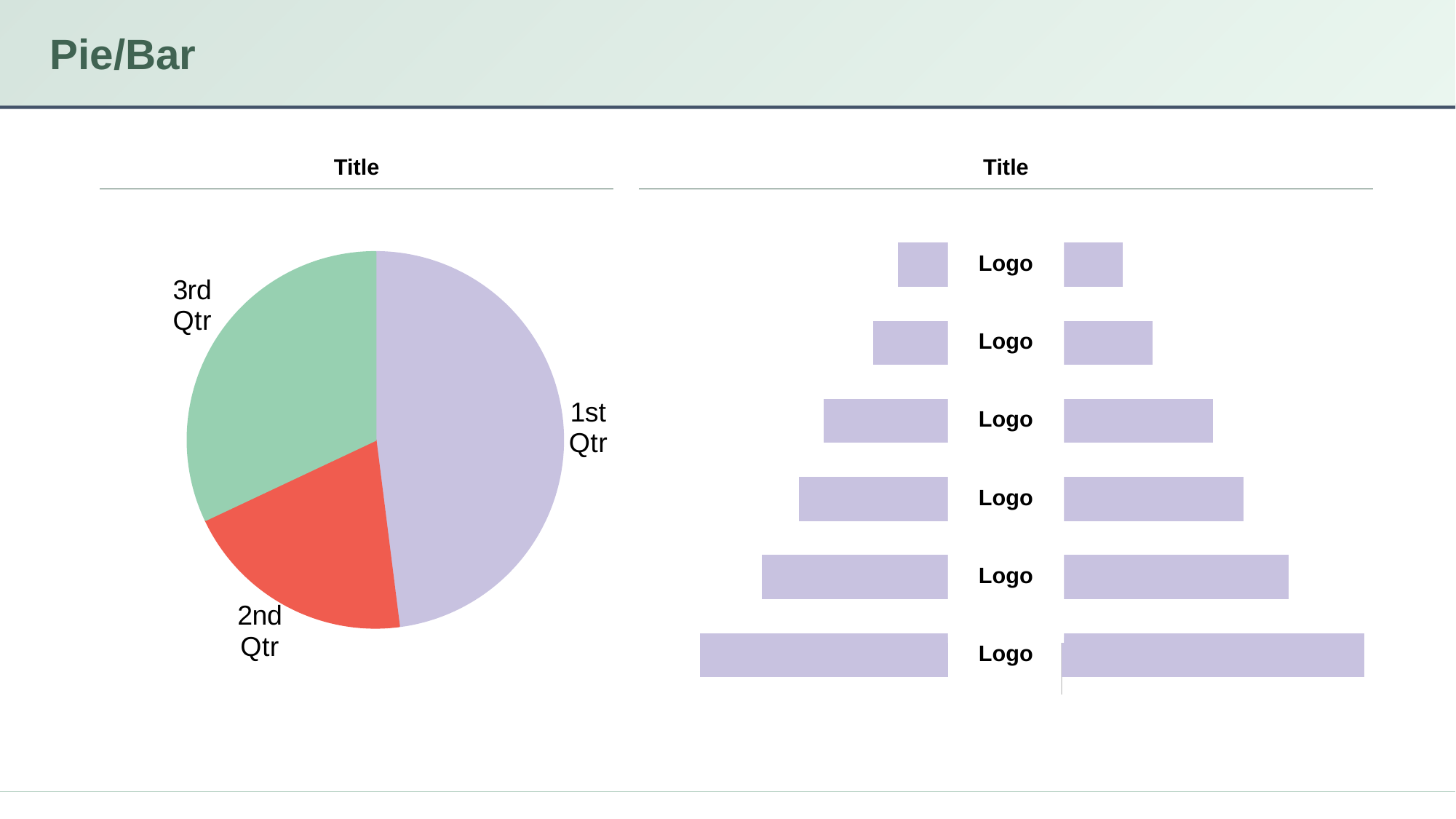
In the pie chart on the left, which slice is the smallest? 2nd Qtr In the bar chart on the right, do the bars get longer or shorter going from the top row to the bottom row? longer In the pie chart on the left, which slice is larger, 2nd Qtr or 3rd Qtr? 3rd Qtr In the pie chart on the left, how many slices are there? 3 What kind of chart is the chart on the left of the slide? pie chart In the bar chart on the right, which row has the longest bars, the top row or the bottom row? bottom row In the bar chart on the right, how many rows of bars are there? 6 In the pie chart on the left, what colour is the 2nd Qtr slice? red What kind of chart is the chart on the right of the slide? bar chart In the pie chart on the left, which slice is larger, 1st Qtr or 3rd Qtr? 1st Qtr In the pie chart on the left, which slice is the largest? 1st Qtr What is the title shown above the pie chart on the left? Title